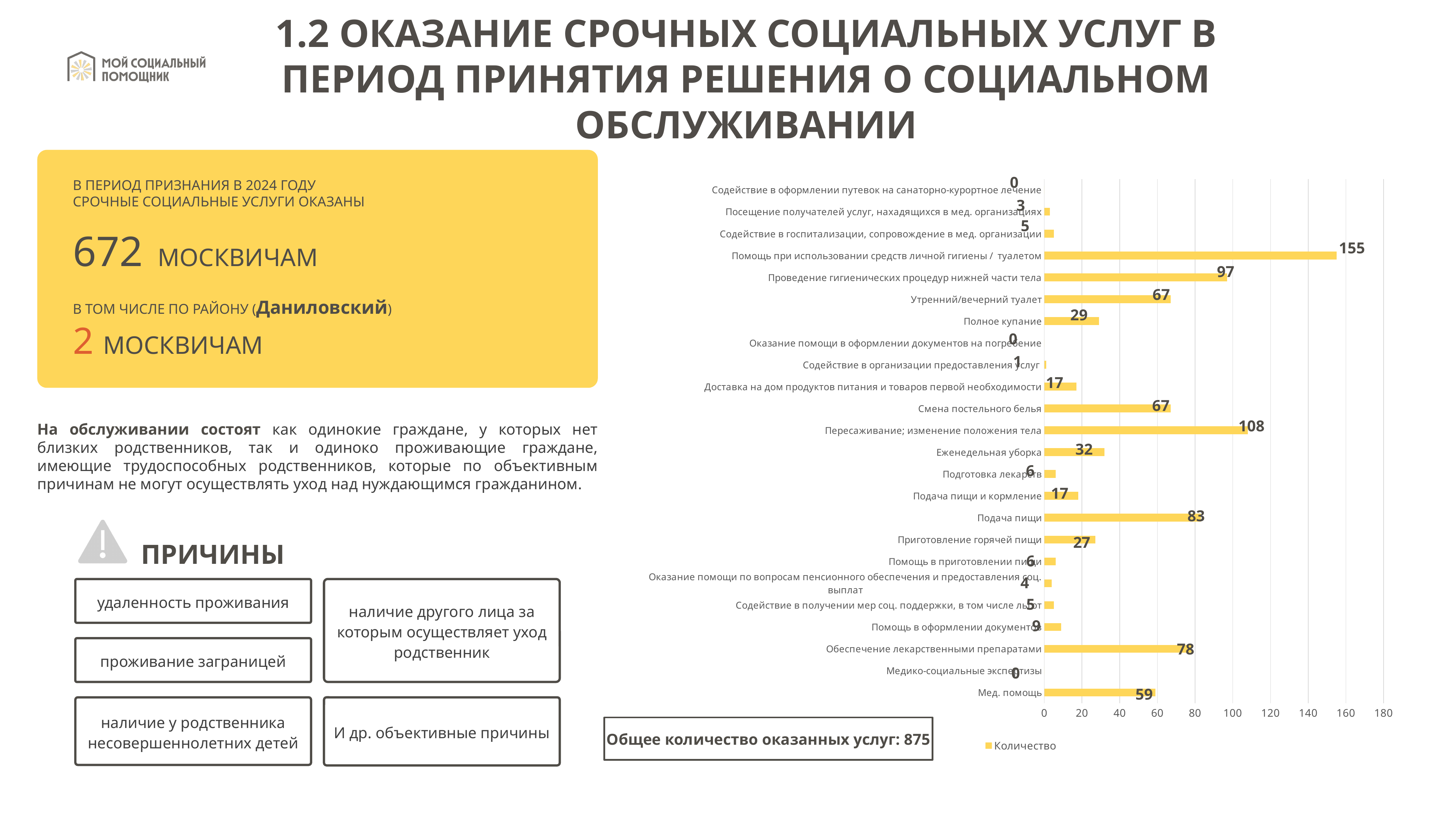
What is the value for Мед. помощь? 59 What is the value for Обеспечение лекарственными препаратами? 78 How many categories are shown in the chart? 24 What is the difference between the values for Помощь при использовании средств личной гигиены / туалетом and Проведение гигиенических процедур нижней части тела? 58 Which category has the highest value? Помощь при использовании средств личной гигиены / туалетом What type of chart is shown on the slide? bar chart Is the value for Утренний/вечерний туалет greater or less than 60? greater What is the name of the series listed in the chart legend? Количество What is the difference between the values for Пересаживание; изменение положения тела and Подача пищи? 25 What is the value for Помощь при использовании средств личной гигиены / туалетом? 155 Which is larger, the value for Еженедельная уборка or the value for Полное купание? Еженедельная уборка What is the value for Пересаживание; изменение положения тела? 108